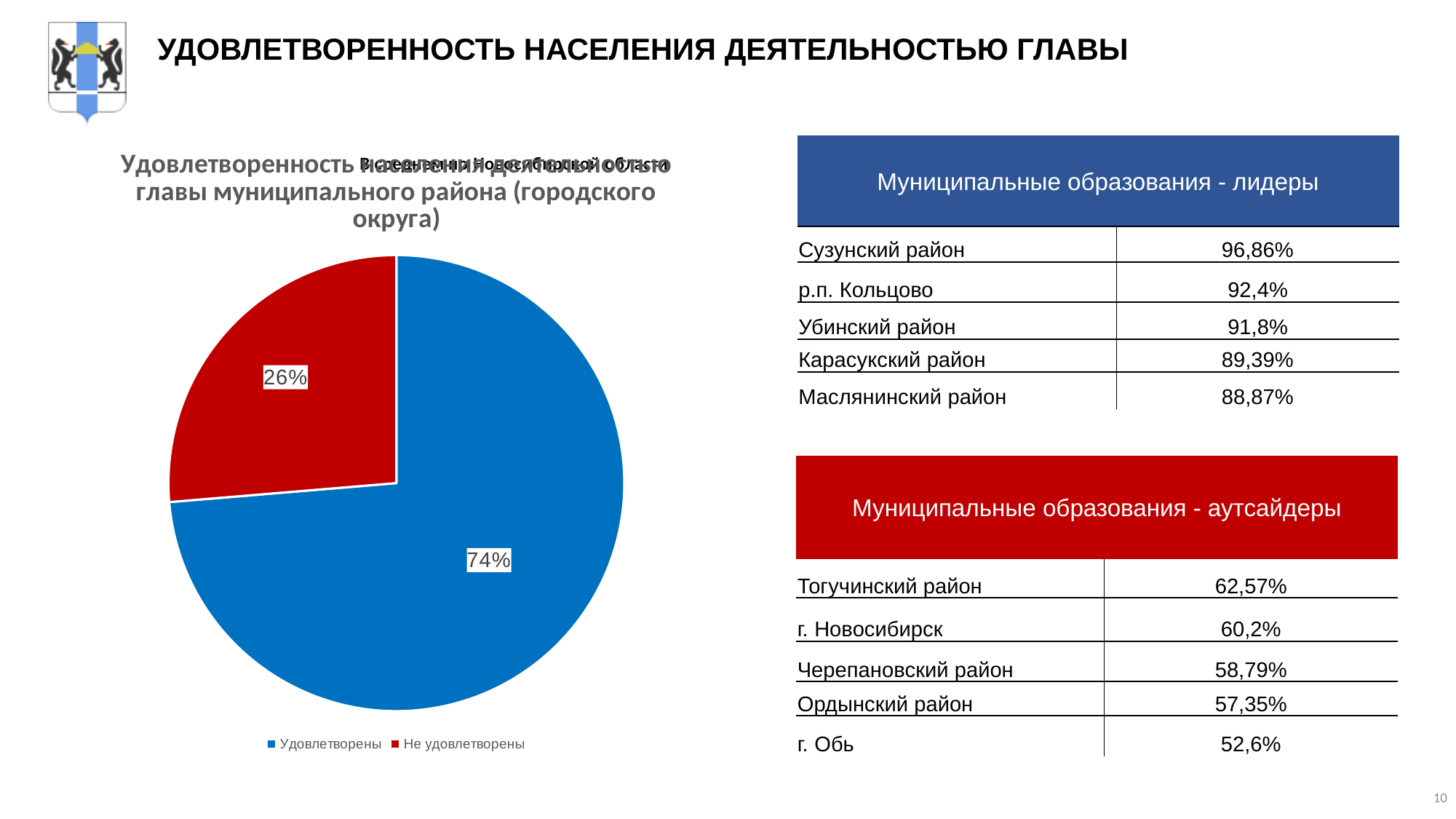
What colour is the "Удовлетворены" slice in the pie chart? blue Which slice of the pie chart is the largest? Удовлетворены What is the difference in percentage points between the "Удовлетворены" and "Не удовлетворены" slices? 48 What colour is the "Не удовлетворены" slice in the pie chart? red What percentage of the pie chart is labelled "Удовлетворены"? 74% How many entries does the pie chart's legend list? 2 Which slice of the pie chart is the smallest? Не удовлетворены What type of chart is shown on the slide? pie chart What share of the pie does the "Не удовлетворены" slice represent? 26% How many slices does the pie chart have? 2 Which is larger in the pie chart: "Удовлетворены" or "Не удовлетворены"? Удовлетворены What percentage of the pie chart is labelled "Не удовлетворены"? 26%